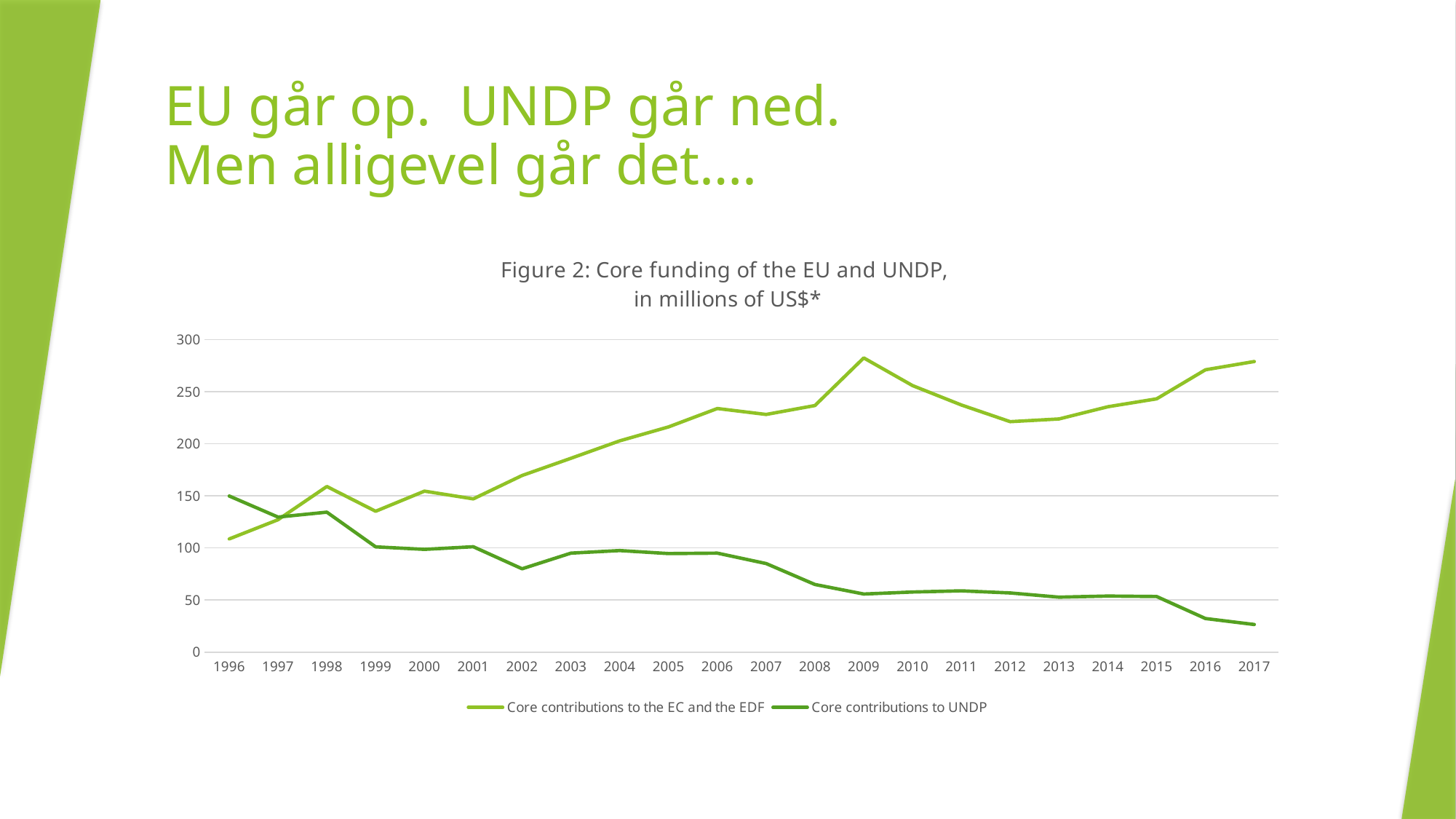
What is the title of the chart? Figure 2: Core funding of the EU and UNDP, in millions of US$* In which year do core contributions to the EC and the EDF reach their highest value? 2009 Which series is drawn in the darker green line? Core contributions to UNDP How many years are plotted along the x axis? 22 What kind of chart is shown on the slide? line chart Do core contributions to UNDP generally rise or fall from 1996 to 2017? fall How many series does the legend list? 2 Is the value for core contributions to the EC and the EDF in 2009 greater or less than 250? greater In which year are core contributions to UNDP at their lowest? 2017 In 1996, which series has the larger value: core contributions to UNDP or core contributions to the EC and the EDF? Core contributions to UNDP In which year are core contributions to UNDP at their highest? 1996 Is the value for core contributions to UNDP in 2017 greater or less than 50? less